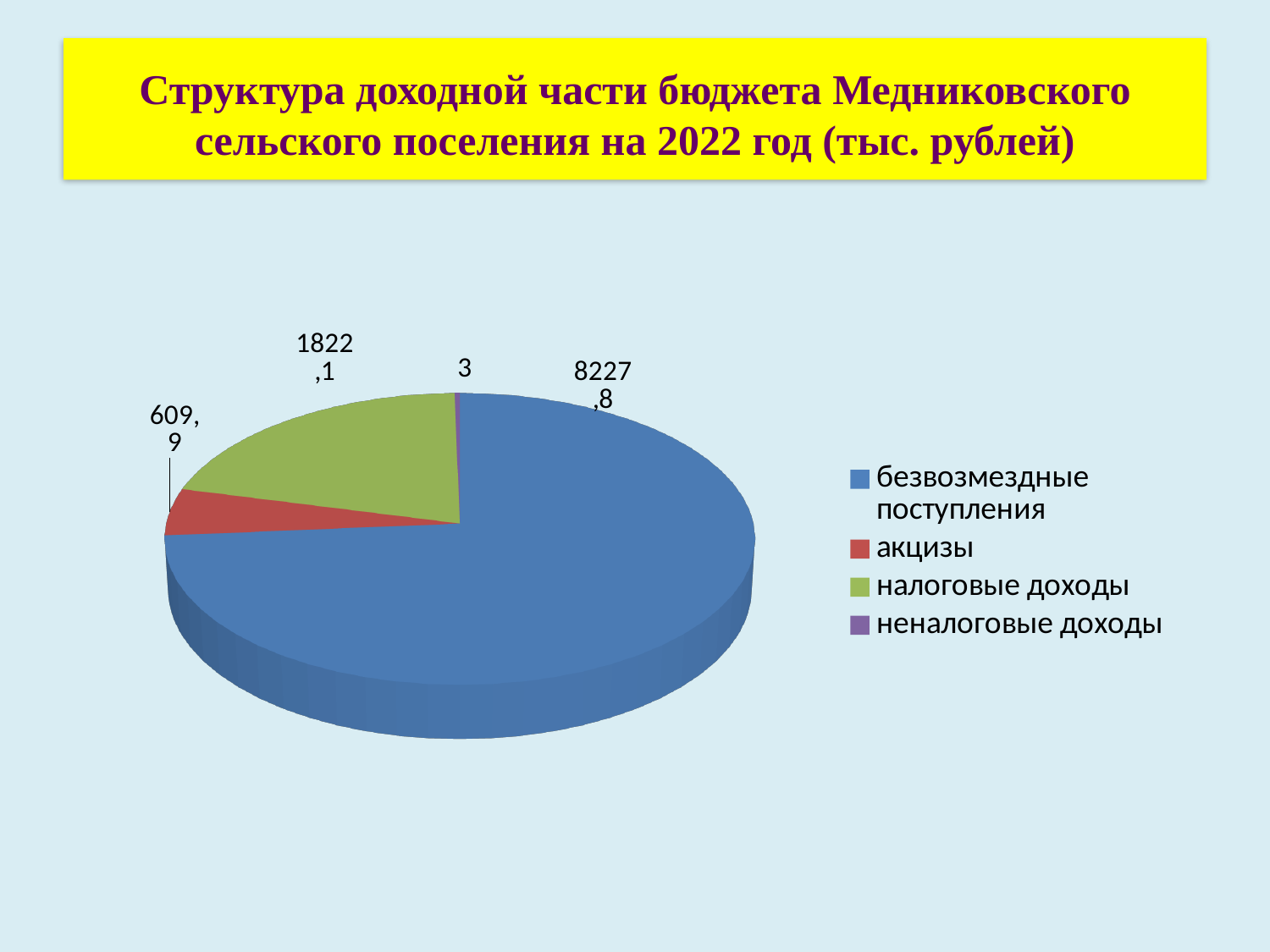
What colour is the slice for акцизы? Red Which category has the smallest slice of the pie? неналоговые доходы What is the difference between безвозмездные поступления and налоговые доходы? 6405,7 How many categories does the legend list? 4 What type of chart is shown on the slide? Pie chart What is the value for налоговые доходы? 1822,1 What is the value for акцизы? 609,9 Which category has the largest slice of the pie? безвозмездные поступления What is the value for неналоговые доходы? 3 What is the difference between налоговые доходы and акцизы? 1212,2 Which is larger, акцизы or налоговые доходы? налоговые доходы What is the value for безвозмездные поступления? 8227,8